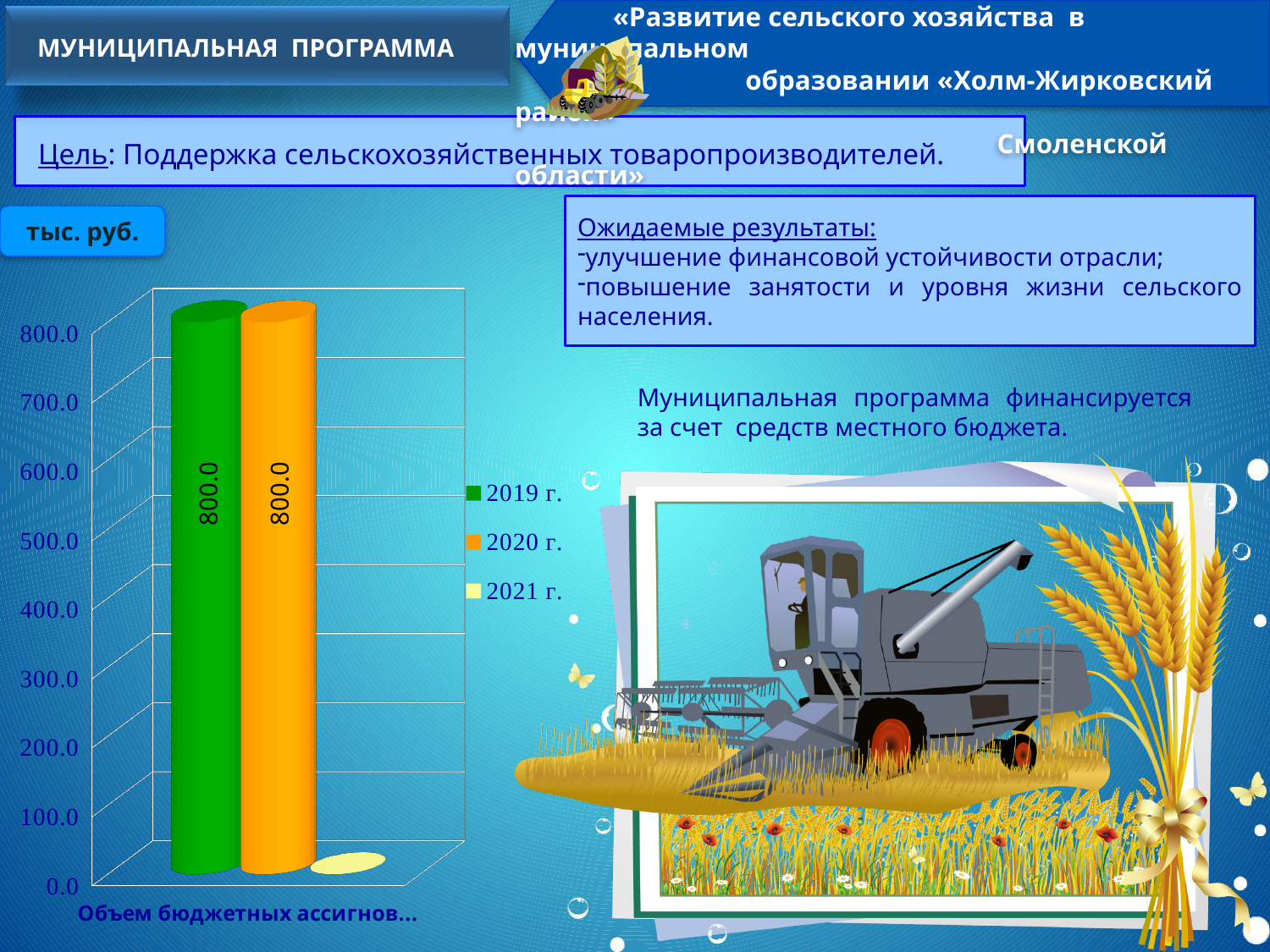
What is the highest tick value shown on the vertical axis of the bar chart? 800.0 What kind of chart is shown on the slide? bar chart How many categories are shown on the x axis of the bar chart? 1 Which series has the lowest value in the bar chart? 2021 г. What colour represents 2020 г. in the bar chart? orange How many series does the legend of the bar chart list? 3 What is the value for 2020 г. in the bar chart? 800.0 What unit is indicated for the values in the bar chart? тыс. руб. What is the value for 2019 г. in the bar chart? 800.0 What is the difference between the values for 2019 г. and 2020 г.? 0.0 Is the value for 2021 г. greater or less than 100.0? less Is the value for 2019 г. larger than, smaller than, or equal to the value for 2020 г.? equal